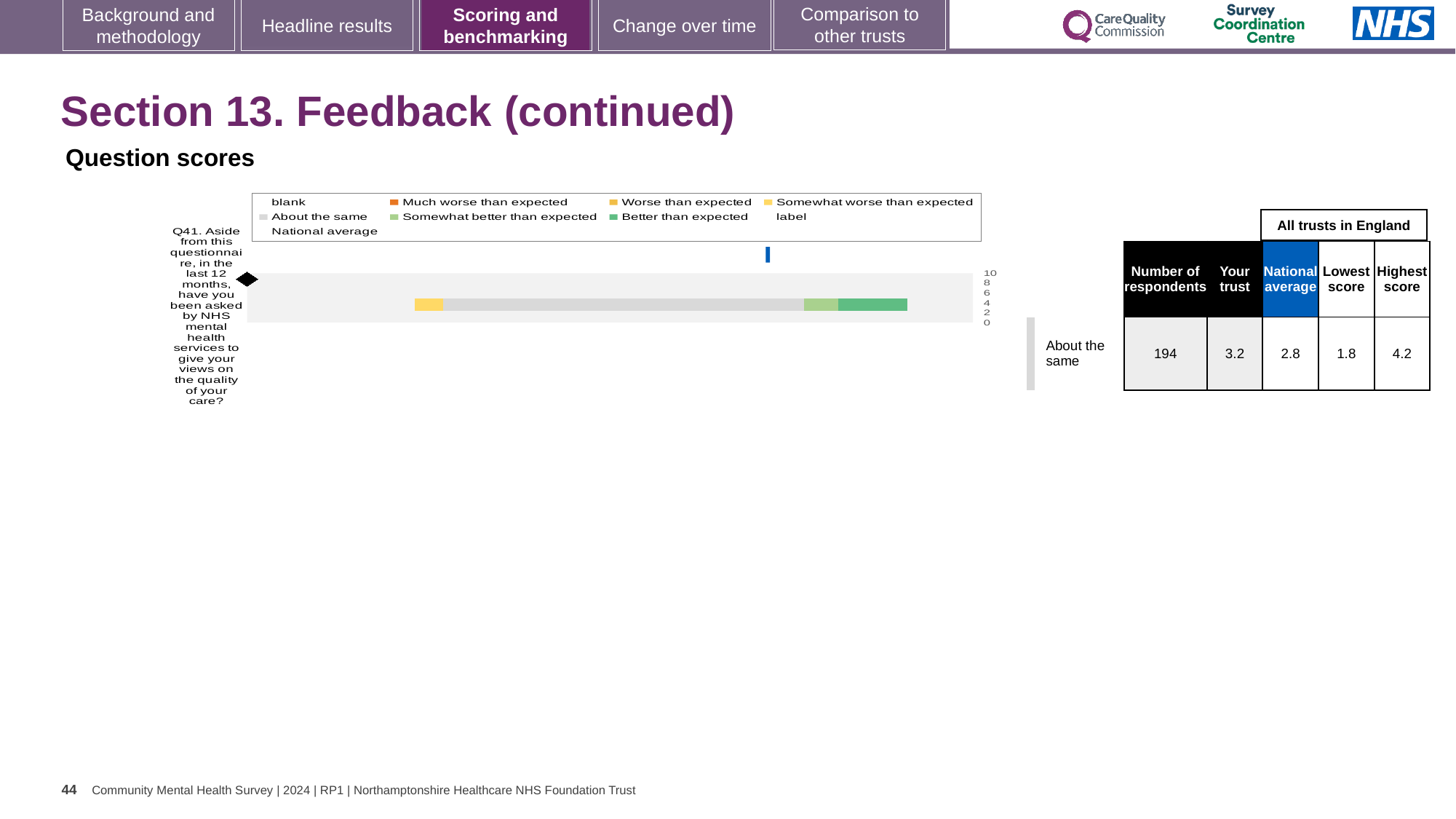
Is the trust's score for Q41 higher or lower than the national average? higher Which benchmark category is the trust's result for Q41 placed in? About the same What is the 'Your trust' score for Q41? 3.2 What is the highest score among all trusts in England for Q41? 4.2 What is the lowest score among all trusts in England for Q41? 1.8 What kind of chart is shown on the slide? bar chart What is the national average score for Q41? 2.8 How many questions (categories) are plotted in the chart? 1 What is the difference between the trust's score and the national average for Q41? 0.4 Which question is plotted in the chart? Q41. Aside from this questionnaire, in the last 12 months, have you been asked by NHS mental health services to give your views on the quality of your care? How many respondents answered Q41? 194 What is the difference between the highest and lowest scores among all trusts in England for Q41? 2.4